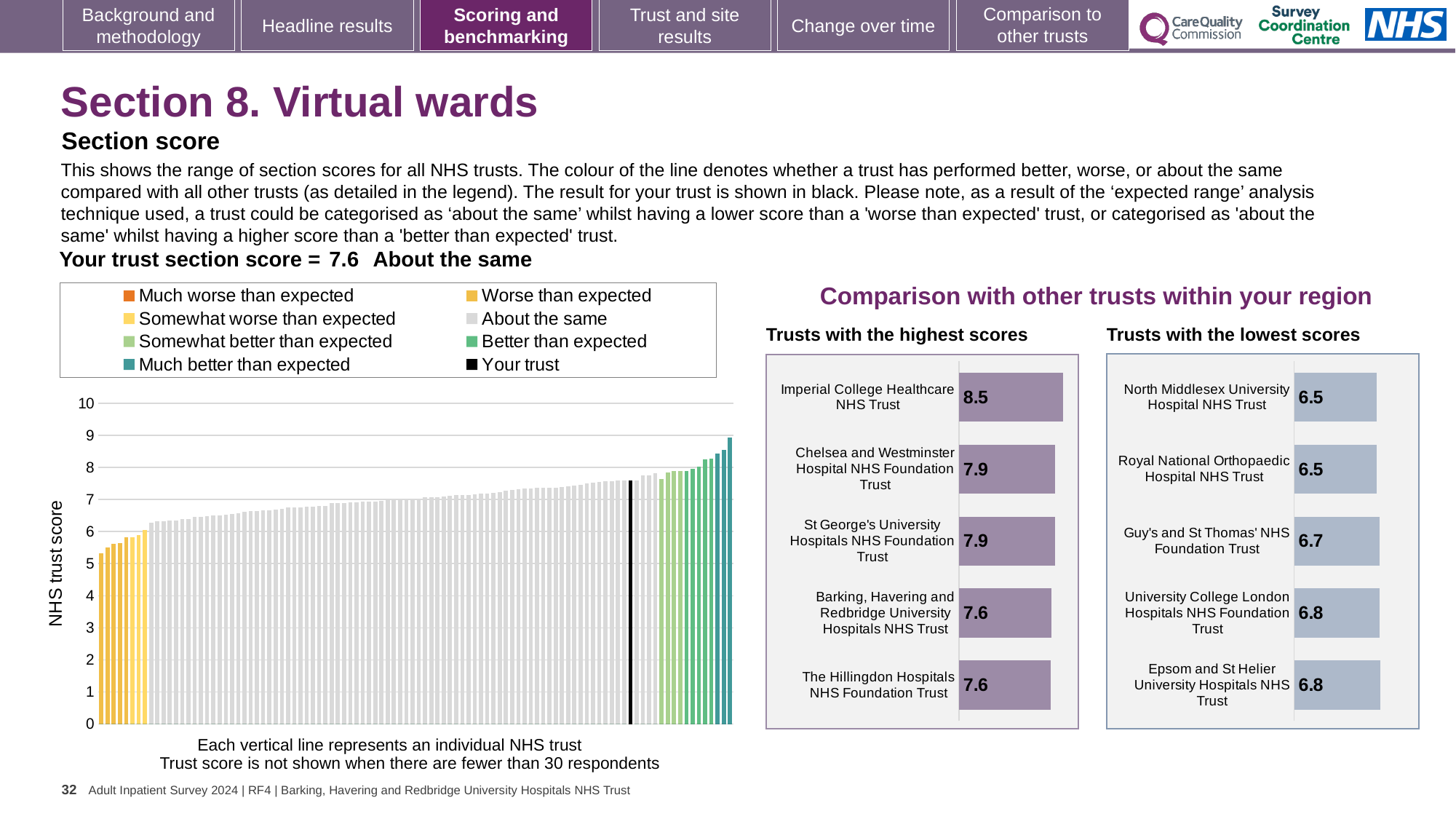
In the 'Trusts with the highest scores' chart, what is the score for Imperial College Healthcare NHS Trust? 8.5 In the 'Trusts with the lowest scores' chart, what is the score for North Middlesex University Hospital NHS Trust? 6.5 In the 'Trusts with the highest scores' chart, what is the score for The Hillingdon Hospitals NHS Foundation Trust? 7.6 What kind of chart is the large chart on the left showing NHS trust scores? Bar chart In the 'Trusts with the lowest scores' chart, what is the difference between the scores of Epsom and St Helier University Hospitals NHS Trust and North Middlesex University Hospital NHS Trust? 0.3 In the 'Trusts with the highest scores' chart, how many trusts are shown? 5 In the large chart on the left, do the trust scores rise or fall from left to right? Rise In the 'Trusts with the lowest scores' chart, which is larger: the score for Guy's and St Thomas' NHS Foundation Trust or the score for Royal National Orthopaedic Hospital NHS Trust? Guy's and St Thomas' NHS Foundation Trust In the 'Trusts with the highest scores' chart, what is the difference between the scores of Imperial College Healthcare NHS Trust and Barking, Havering and Redbridge University Hospitals NHS Trust? 0.9 In the 'Trusts with the highest scores' chart, which trust has the highest score? Imperial College Healthcare NHS Trust In the 'Trusts with the lowest scores' chart, what is the score for Guy's and St Thomas' NHS Foundation Trust? 6.7 How many entries does the legend of the large chart on the left list? 8